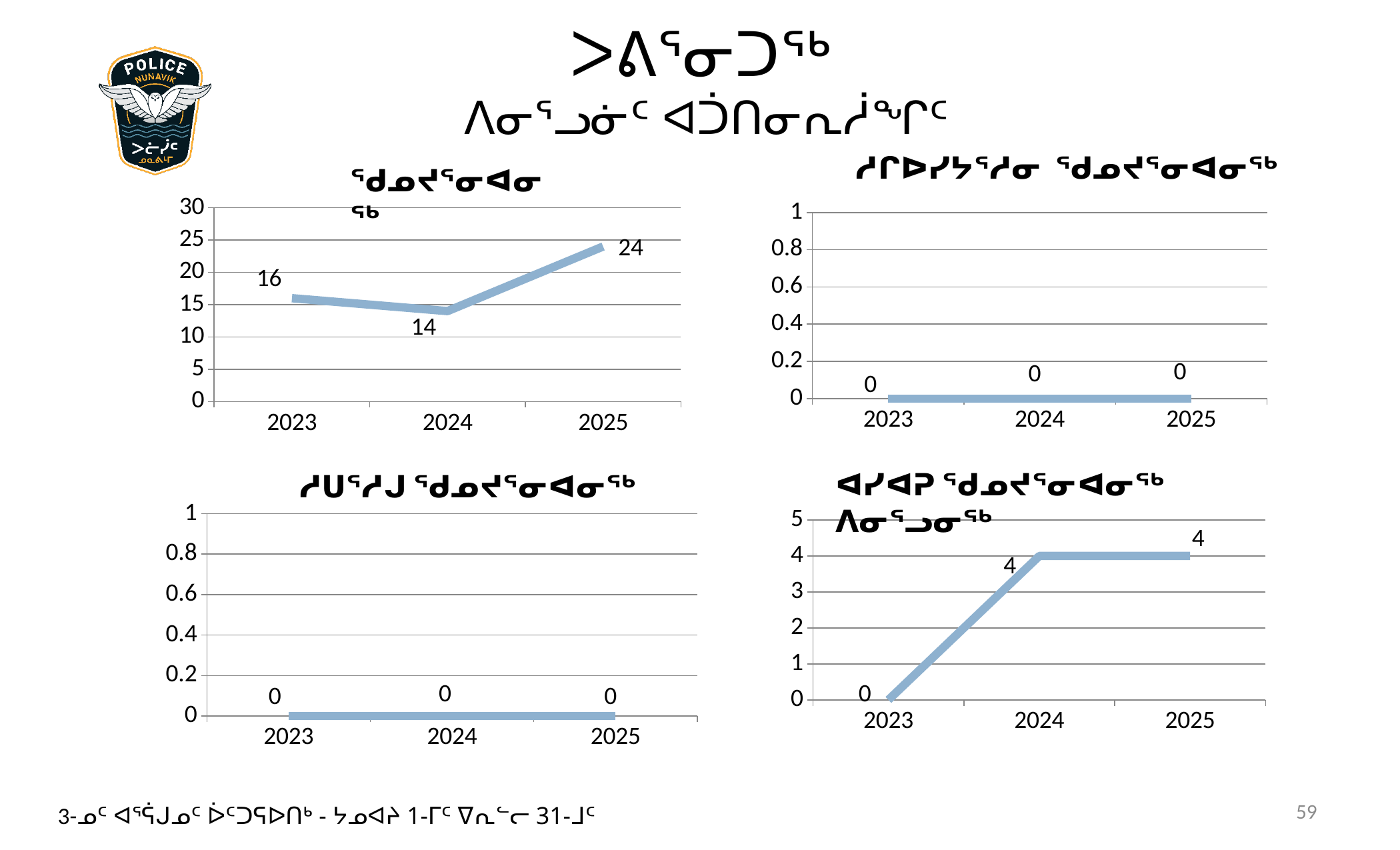
In the top-left chart, which year has the lowest value? 2024 In the top-left chart, what is the value for 2025? 24 In the top-right chart, what is the value for 2025? 0 In the bottom-right chart, what is the value for 2024? 4 How many years are plotted on the x axis of the bottom-left chart? 3 What kind of chart is the bottom-right chart? line chart In the top-left chart, what is the value for 2024? 14 In the top-left chart, what is the difference between the values for 2025 and 2024? 10 In the top-left chart, is the value for 2023 larger or smaller than the value for 2025? smaller In the top-left chart, which year has the highest value? 2025 In the bottom-right chart, what is the value for 2023? 0 In the top-left chart, what is the value for 2023? 16